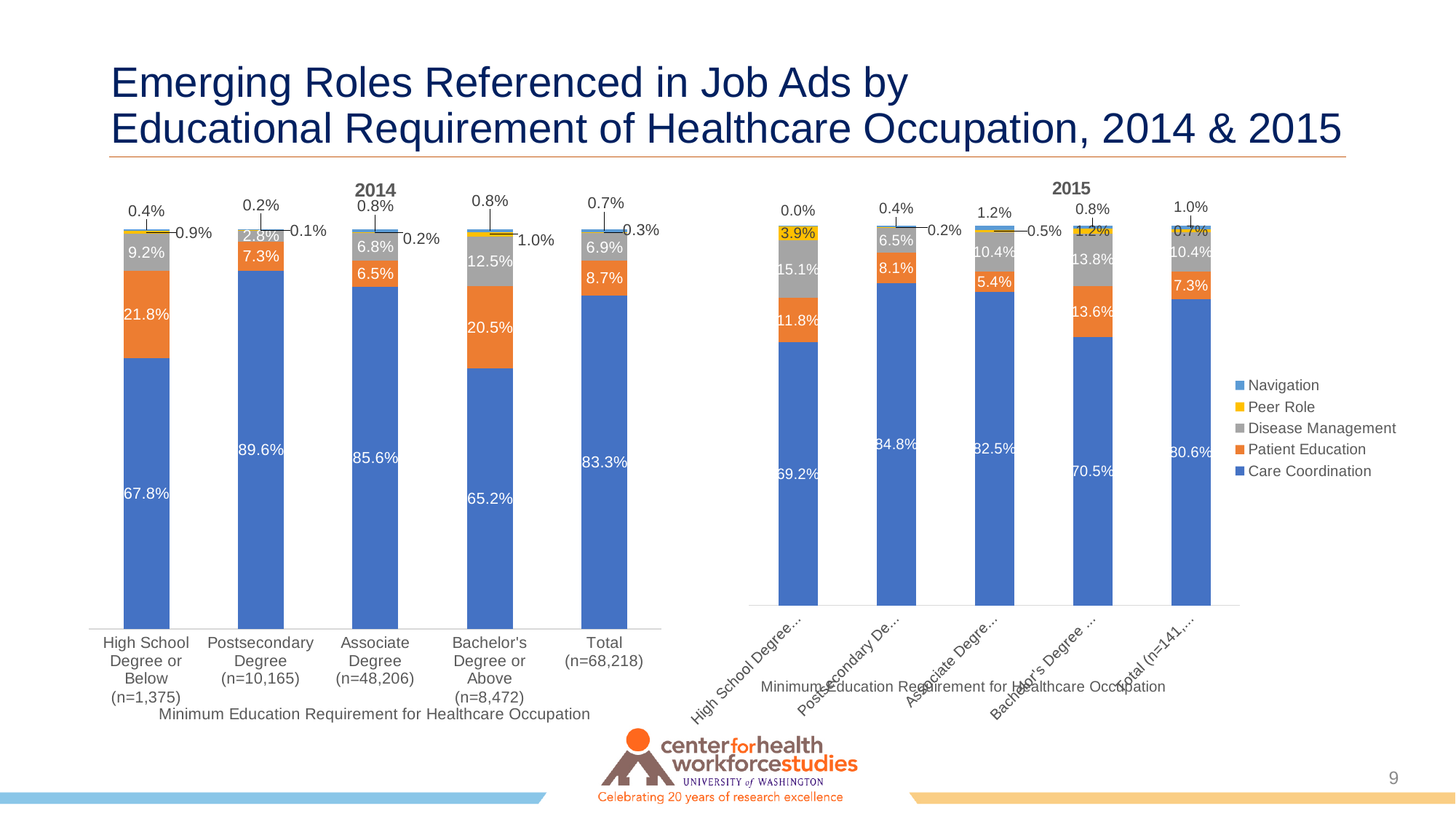
In the 2014 chart, what is the Patient Education value for Bachelor's Degree or Above? 20.5% In the 2015 chart, what is the Care Coordination value for the Total bar? 80.6% What colour represents Care Coordination in the legend? Blue How many education categories are shown in the 2014 chart? 5 In the 2014 chart, what is the difference between the Patient Education value for High School Degree or Below and for Total? 13.1 percentage points In the 2014 chart, which education category has the lowest Care Coordination share? Bachelor's Degree or Above In the 2014 chart, which education category has the highest Care Coordination share? Postsecondary Degree In the 2014 chart, what is the Care Coordination value for Postsecondary Degree? 89.6% In the 2015 chart, what is the Peer Role value for the first bar (High School Degree)? 3.9% What kind of chart is the 2014 chart on the left? Stacked bar chart How many series does the legend list? 5 In the 2014 chart, which has the larger Disease Management value: High School Degree or Below or Bachelor's Degree or Above? Bachelor's Degree or Above